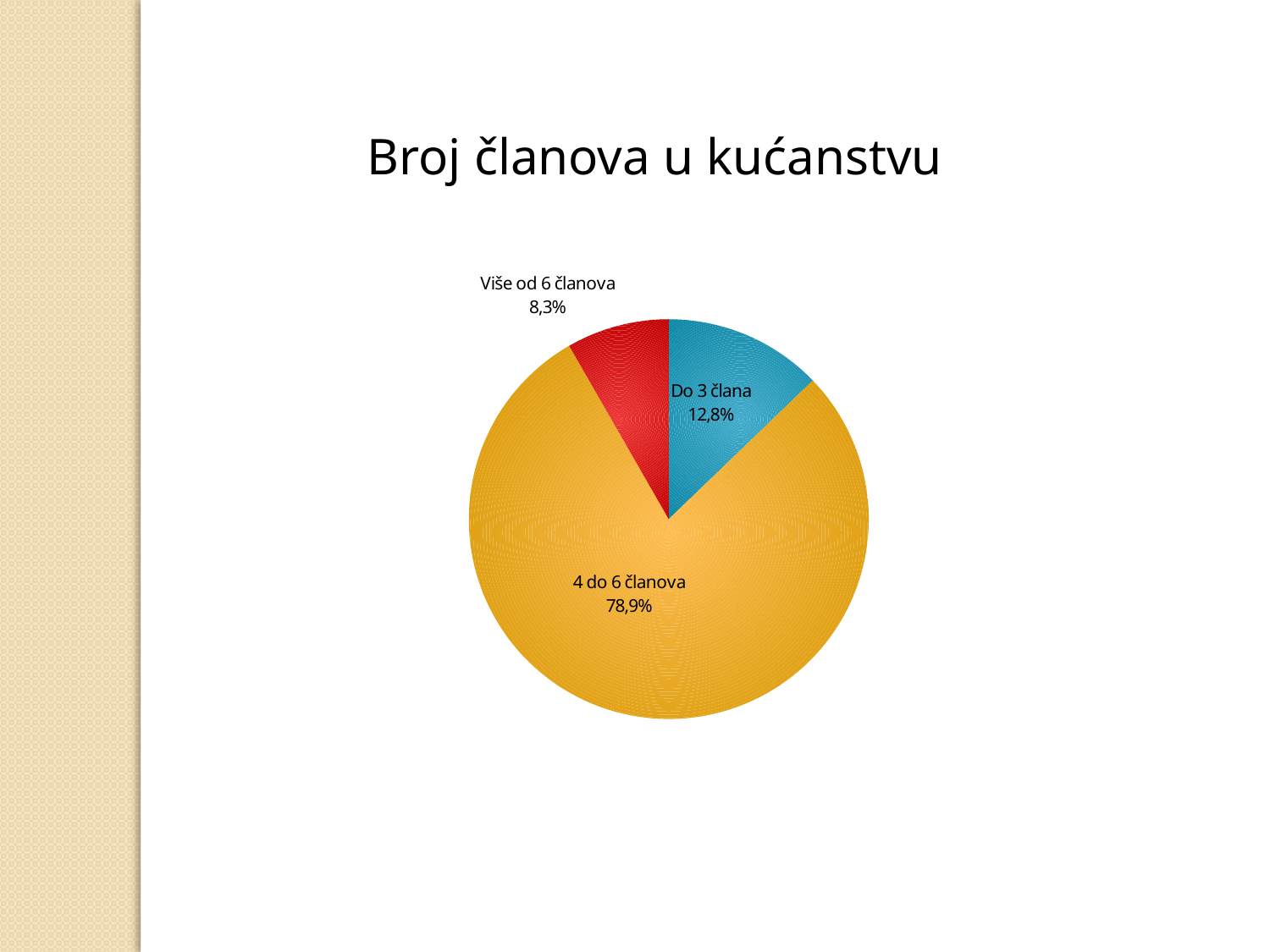
What share of the pie does "Više od 6 članova" have? 8,3% Which category has the smallest slice? Više od 6 članova How many slices does the pie chart have? 3 Which category has the largest slice? 4 do 6 članova What kind of chart is shown on the slide? pie chart Which is larger, the slice for "Do 3 člana" or the slice for "Više od 6 članova"? Do 3 člana What share of the pie does "4 do 6 članova" have? 78,9% What colour is the slice for "Više od 6 članova"? red What is the title of the chart? Broj članova u kućanstvu What is the difference in percentage points between "4 do 6 članova" and "Do 3 člana"? 66,1 What share of the pie does "Do 3 člana" have? 12,8% What is the difference in percentage points between "Do 3 člana" and "Više od 6 članova"? 4,5